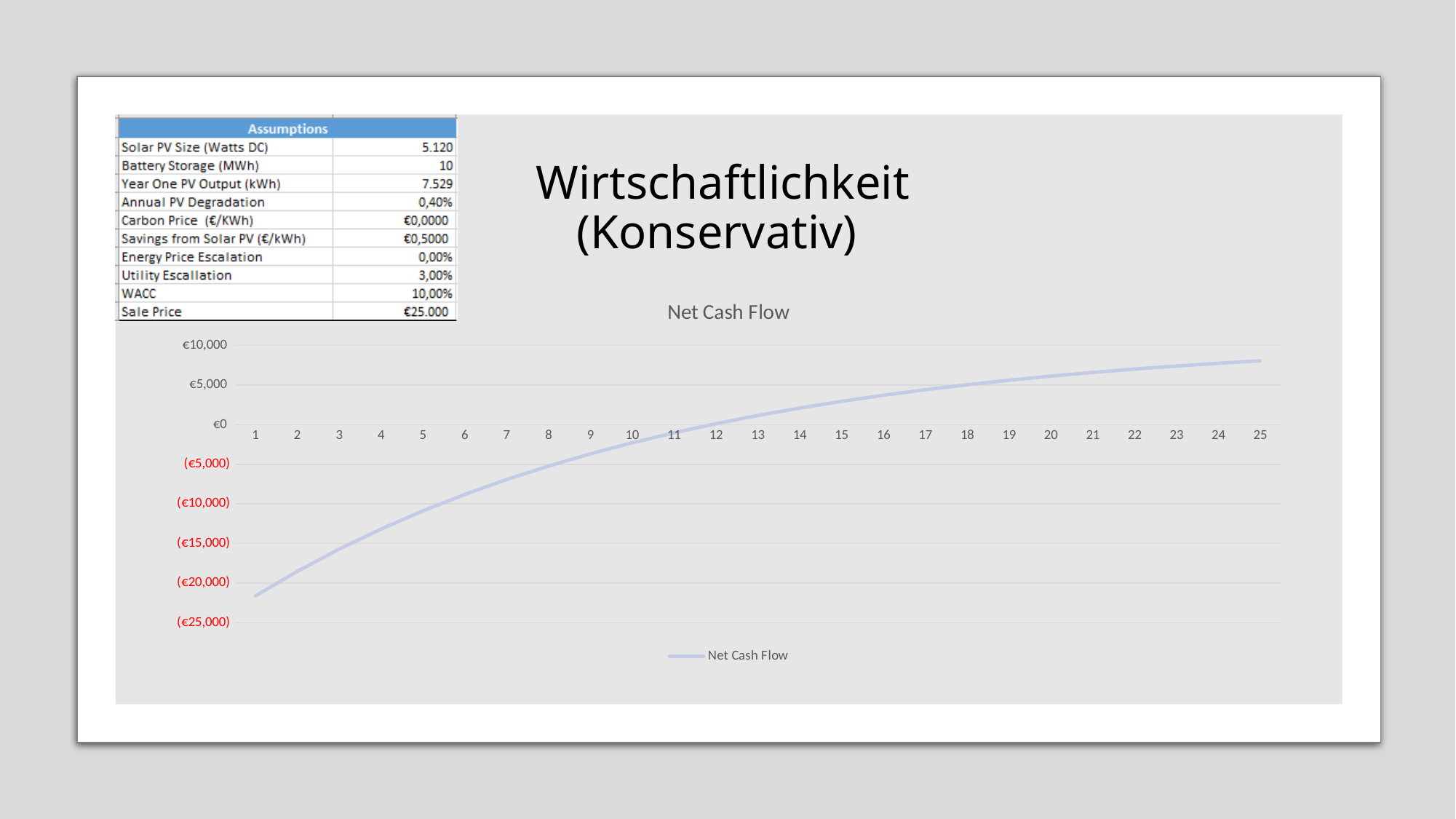
Which is larger, the Net Cash Flow in year 1 or in year 25? year 25 How many points (years) are plotted along the x axis of the Net Cash Flow chart? 25 What is the title of the chart? Net Cash Flow Is the Net Cash Flow value for year 1 greater or less than (€20,000)? less Is the Net Cash Flow value for year 25 greater or less than €5,000? greater At which year is the Net Cash Flow highest? 25 Does the Net Cash Flow line rise or fall from year 1 to year 25? rise Is the Net Cash Flow value for year 3 greater or less than (€20,000)? greater At which year is the Net Cash Flow lowest? 1 What kind of chart is shown on the slide? line chart How many series does the chart legend list? 1